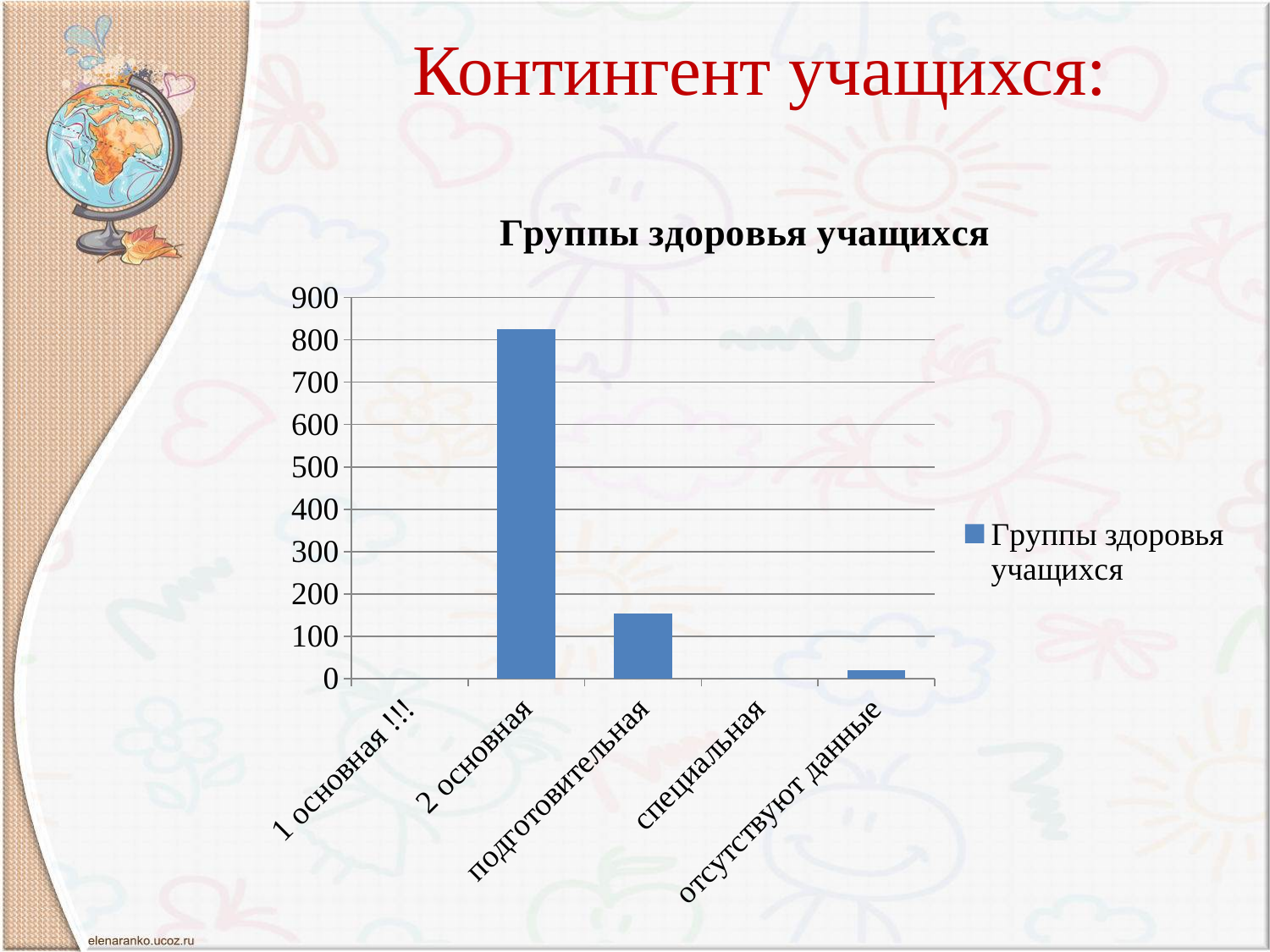
How many categories are shown on the x axis of the chart? 5 Which category has the highest value? 2 основная Which is larger, the value for 2 основная or the value for подготовительная? 2 основная What is the title of the chart? Группы здоровья учащихся What kind of chart is shown on the slide? bar chart Is the value for подготовительная greater or less than 100? greater How many series does the legend list? 1 Is the value for подготовительная greater or less than 200? less Which is larger, the value for подготовительная or the value for отсутствуют данные? подготовительная Is the value for 2 основная greater or less than 700? greater What is the legend entry of the chart? Группы здоровья учащихся